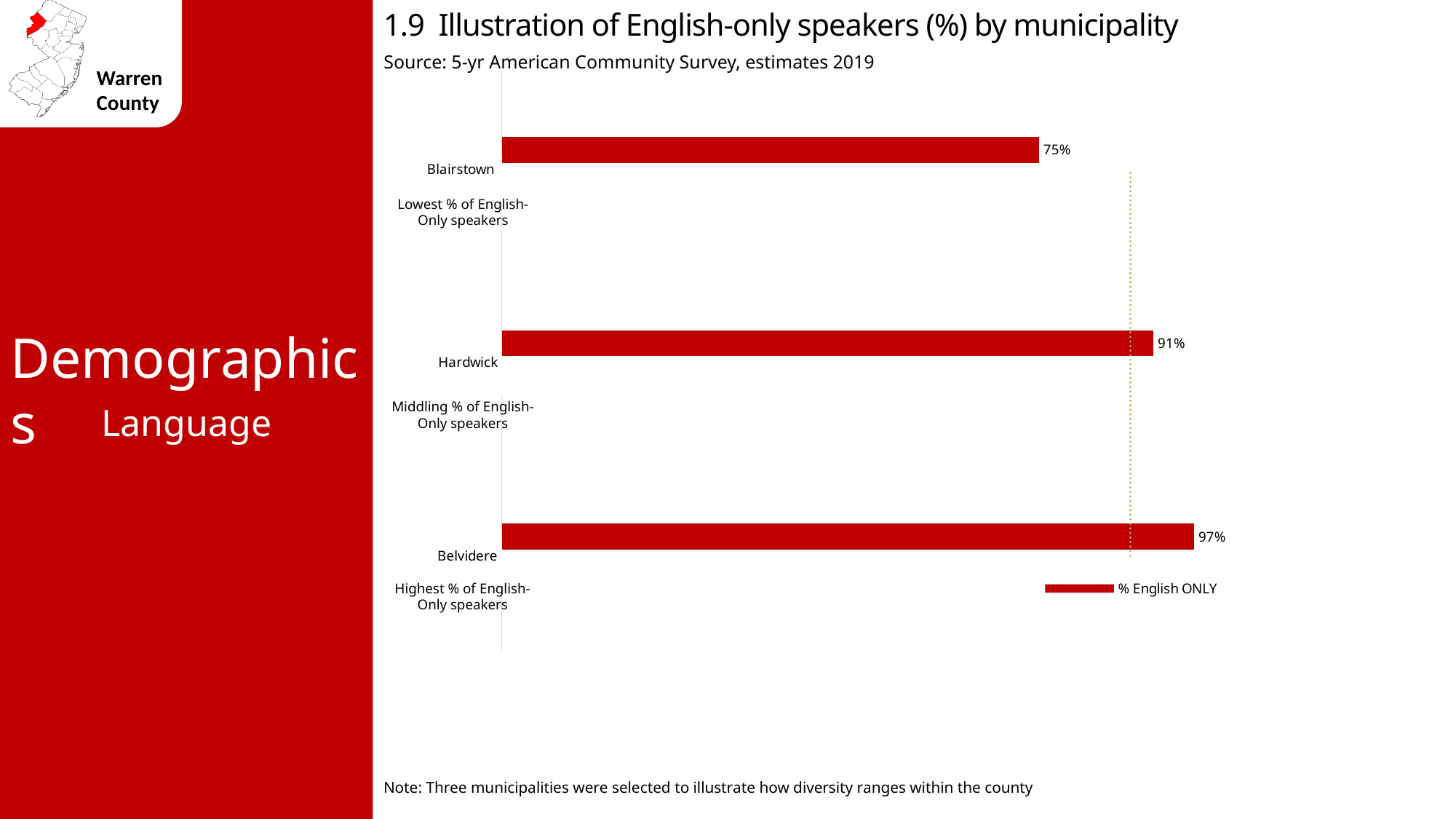
How many municipalities are shown in the chart? 3 What is the percentage of English-only speakers in Hardwick? 91% What kind of chart is shown on the slide? Bar chart Which has a higher percentage of English-only speakers, Hardwick or Blairstown? Hardwick What is the difference in percentage points between Hardwick and Blairstown? 16 What is the percentage of English-only speakers in Belvidere? 97% Which municipality has the lowest percentage of English-only speakers? Blairstown Which municipality has the highest percentage of English-only speakers? Belvidere What is the difference in percentage points between Belvidere and Blairstown? 22 What is the percentage of English-only speakers in Blairstown? 75% How many series does the legend list? 1 What is the legend entry for the series in the chart? % English ONLY